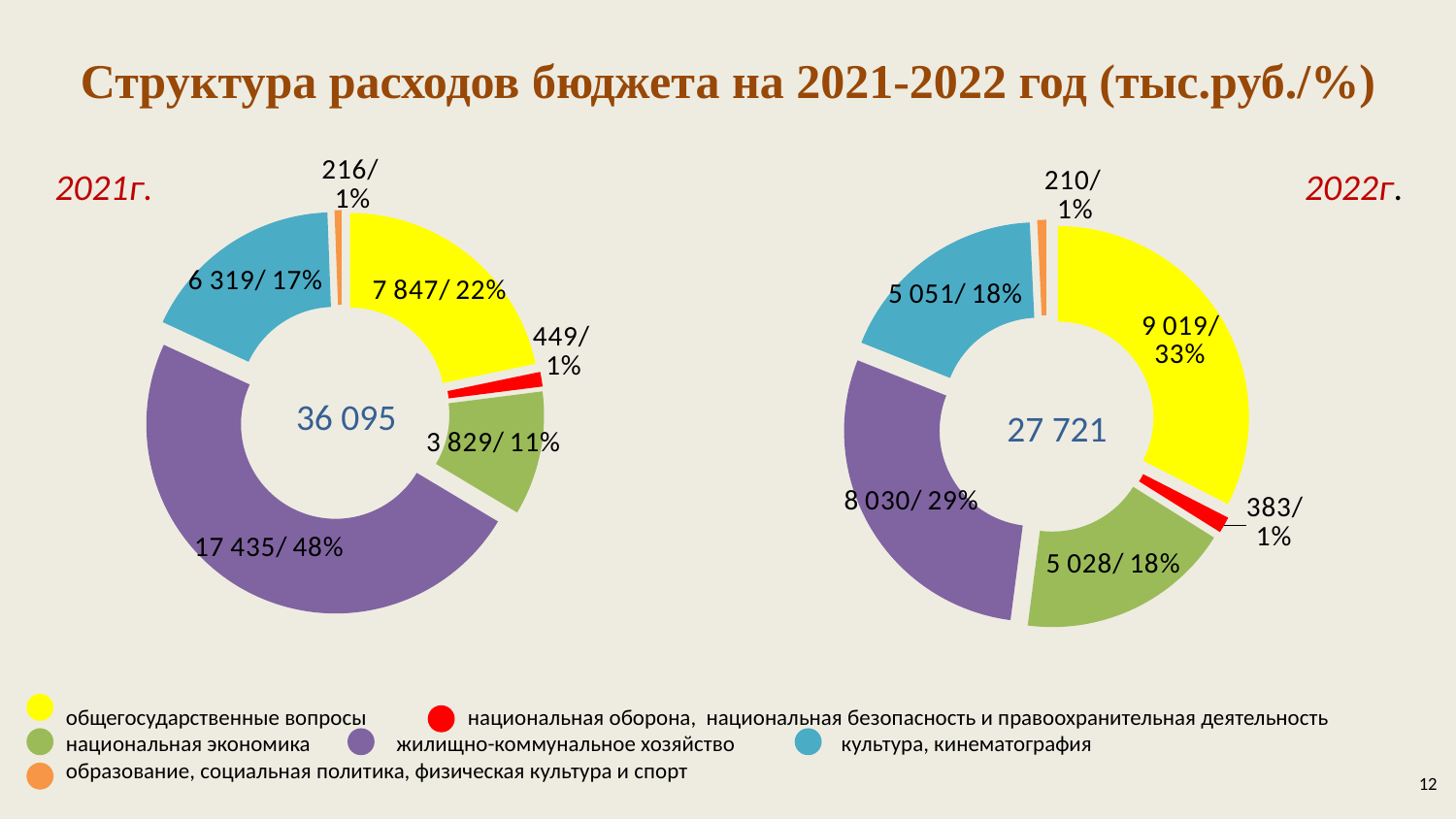
On the 2021 chart, which is larger: культура, кинематография or национальная экономика? культура, кинематография On the 2022 chart, what value is shown for культура, кинематография (blue slice)? 5 051/ 18% What type of chart is used on this slide? doughnut (pie) chart On the 2022 chart, what percentage share does жилищно-коммунальное хозяйство have? 29% On the 2022 chart, which category has the largest share? общегосударственные вопросы On the 2021 chart, what value is shown for жилищно-коммунальное хозяйство (purple slice)? 17 435/ 48% What total is shown in the centre of the 2021 chart? 36 095 On the 2021 chart, what value is shown for национальная экономика (green slice)? 3 829/ 11% How many categories does the legend list? 6 On the 2022 chart, what value is shown for общегосударственные вопросы (yellow slice)? 9 019/ 33% What total is shown in the centre of the 2022 chart? 27 721 On the 2021 chart, which category has the largest share? жилищно-коммунальное хозяйство